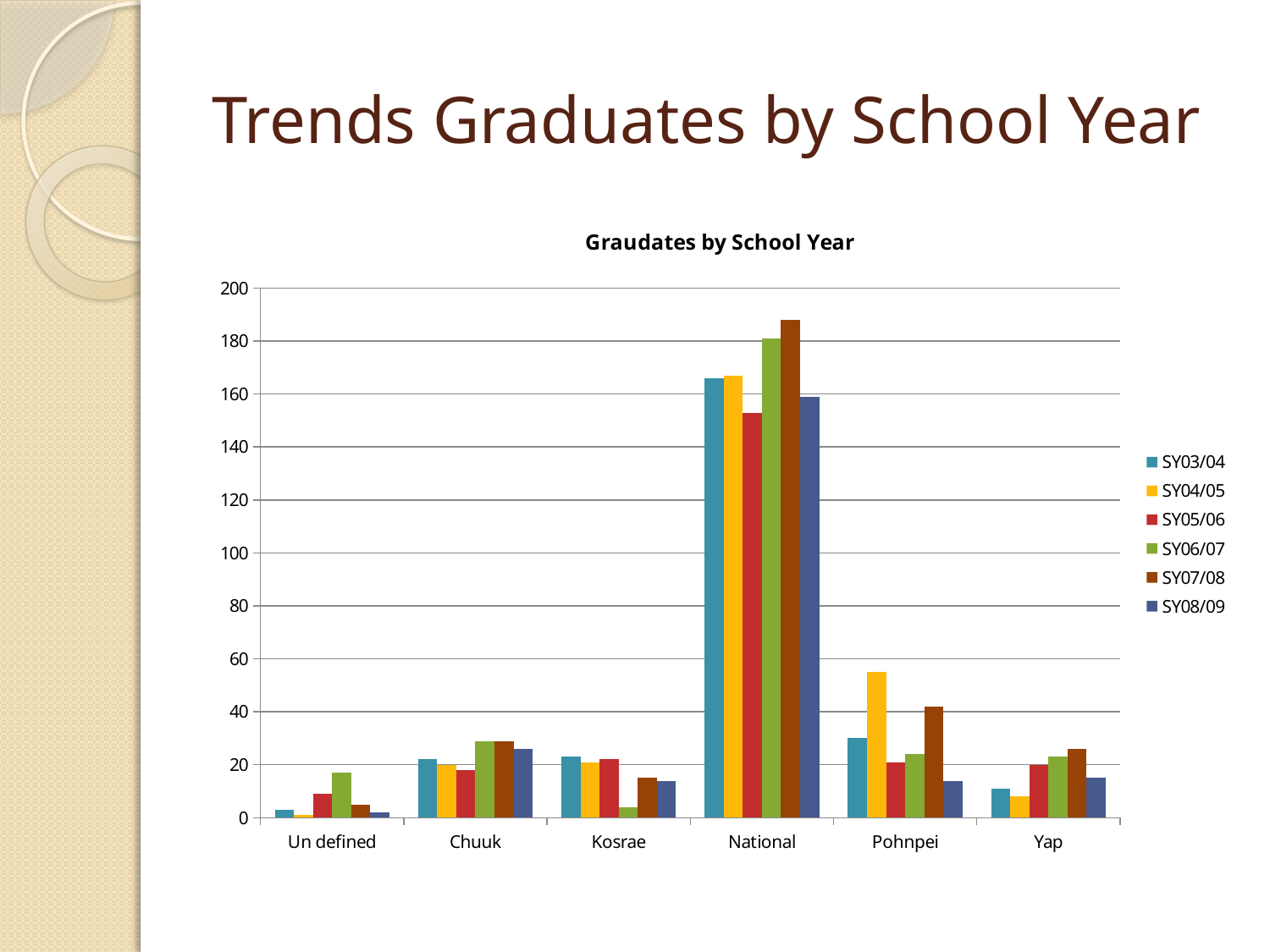
Is the value for National in SY07/08 greater or less than 180? greater How many series does the legend list? 6 How many categories are shown along the x axis? 6 For the National category, which school year has the highest bar? SY07/08 Which is larger for SY06/07: the value for Chuuk or the value for Kosrae? Chuuk For the Kosrae category, which school year has the lowest bar? SY06/07 Is the value for Pohnpei in SY04/05 greater or less than 40? greater What kind of chart is shown on the slide? Bar chart For the Pohnpei category, which school year has the highest bar? SY04/05 Which category has the highest number of graduates across all school years? National Is the value for National in SY05/06 greater or less than 160? less What is the title printed above the chart? Graudates by School Year